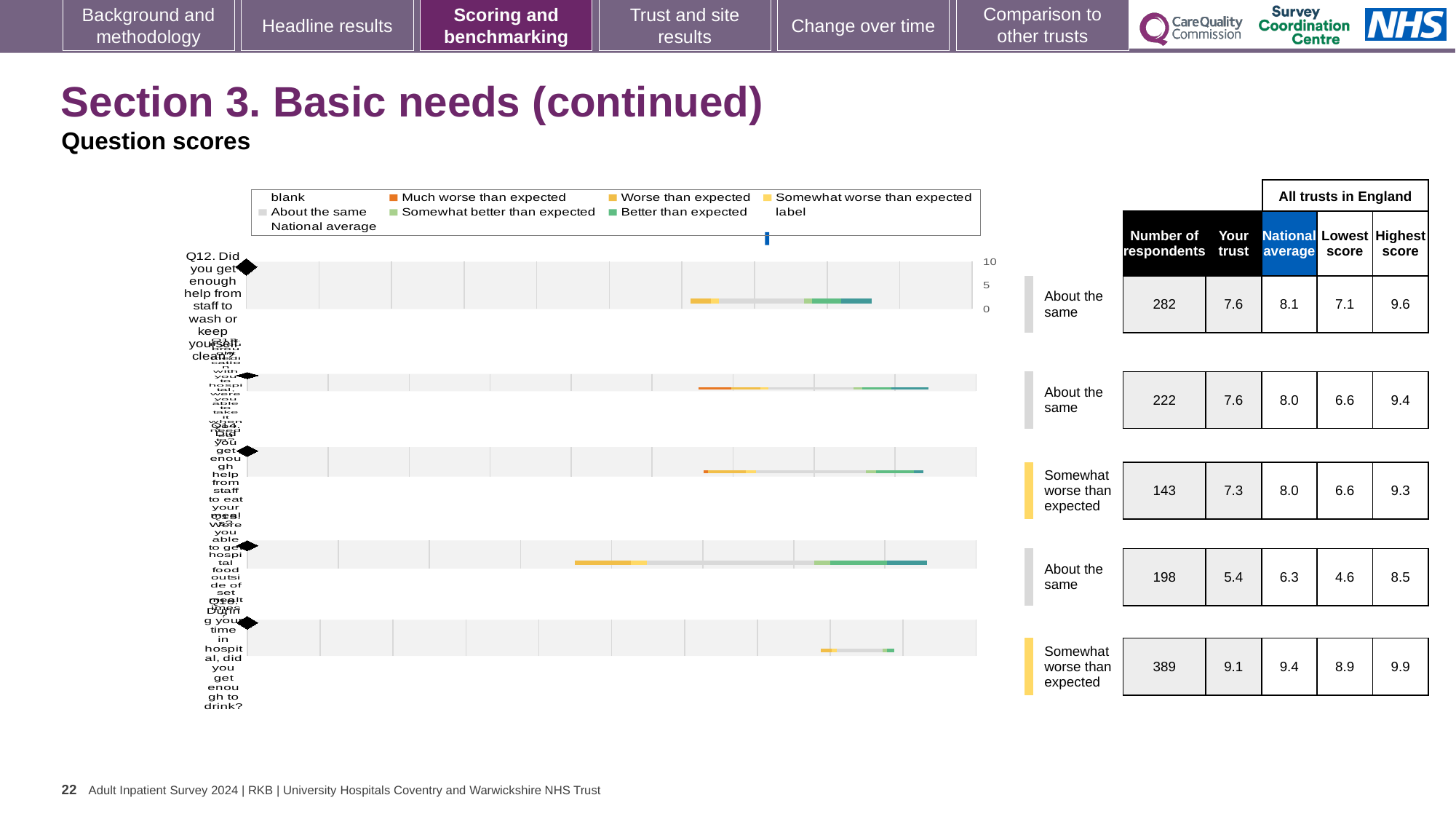
What kind of chart is used to show the question scores on this slide? bar chart What is the subtitle shown above the chart on this slide? Question scores What benchmark category is shown for Q12 (help from staff to wash or keep yourself clean)? About the same For Q12, what is the difference between the highest score (9.6) and the lowest score (7.1)? 2.5 For Q12 (help from staff to wash or keep yourself clean), what is the 'Your trust' score? 7.6 For Q12 (help from staff to wash or keep yourself clean), what is the number of respondents shown in the table? 282 For Q12 (help from staff to wash or keep yourself clean), what is the highest score among all trusts in England? 9.6 In the chart legend, what colour represents 'Much worse than expected'? orange For Q12 (help from staff to wash or keep yourself clean), what is the national average score? 8.1 For Q12, which is larger: the 'Your trust' score or the national average? National average What is the 'Your trust' score for the bottom row of the table (the fifth question, about getting enough to drink)? 9.1 How many questions (bars) are plotted in the question scores chart? 5